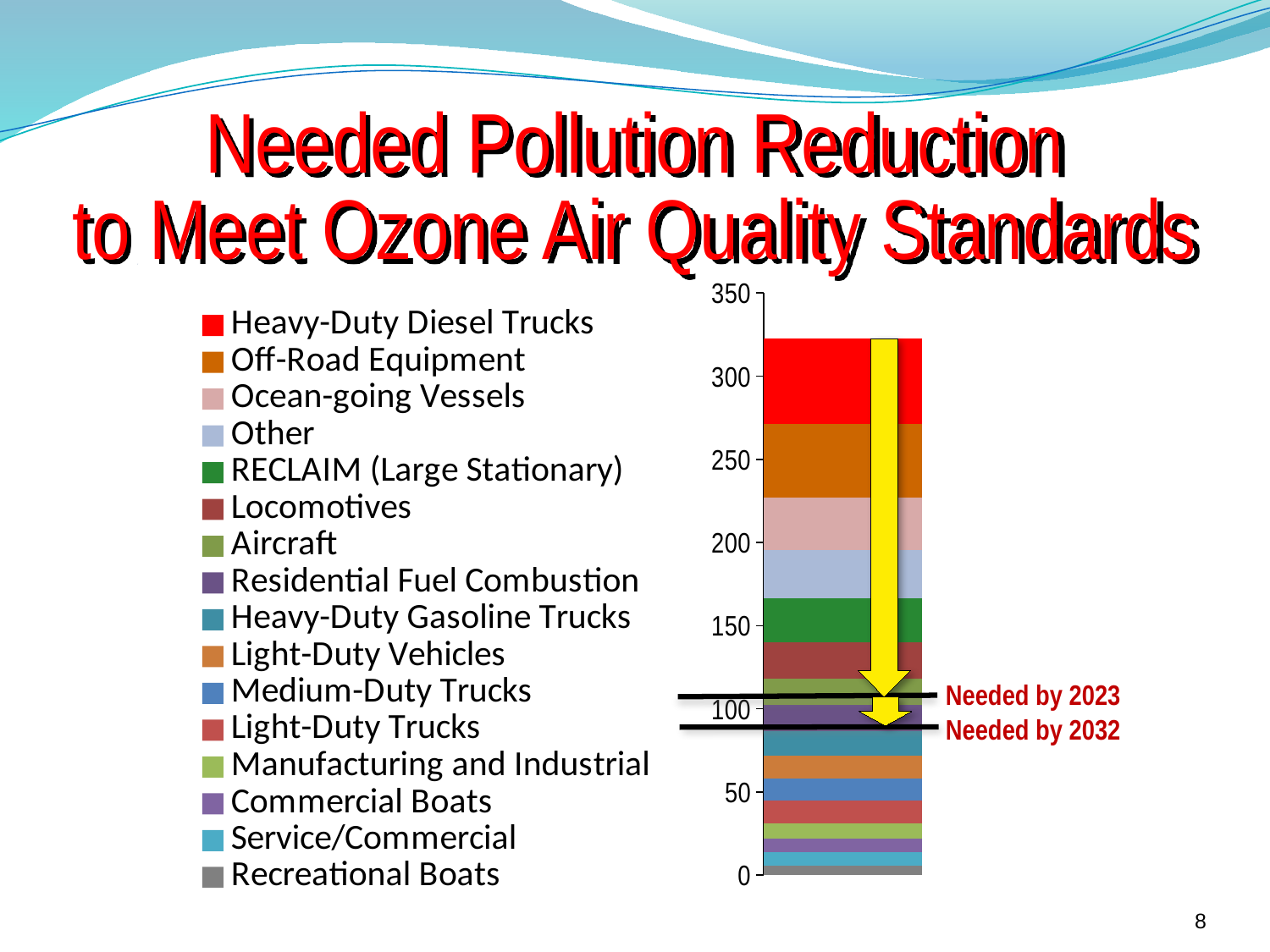
Which segment is larger: Heavy-Duty Diesel Trucks or Ocean-going Vessels? Heavy-Duty Diesel Trucks Is the total height of the stacked bar greater or less than 350? less Which series forms the smallest segment of the stacked bar? Recreational Boats What kind of chart is shown on the slide? Stacked bar chart How many series does the chart legend list? 16 What is the highest value shown on the vertical axis? 350 What colour represents Heavy-Duty Diesel Trucks in the chart? Red Which series forms the largest segment of the stacked bar? Heavy-Duty Diesel Trucks Is the total height of the stacked bar greater or less than 300? greater Which segment is larger: Off-Road Equipment or Locomotives? Off-Road Equipment How many bars are plotted in the chart? 1